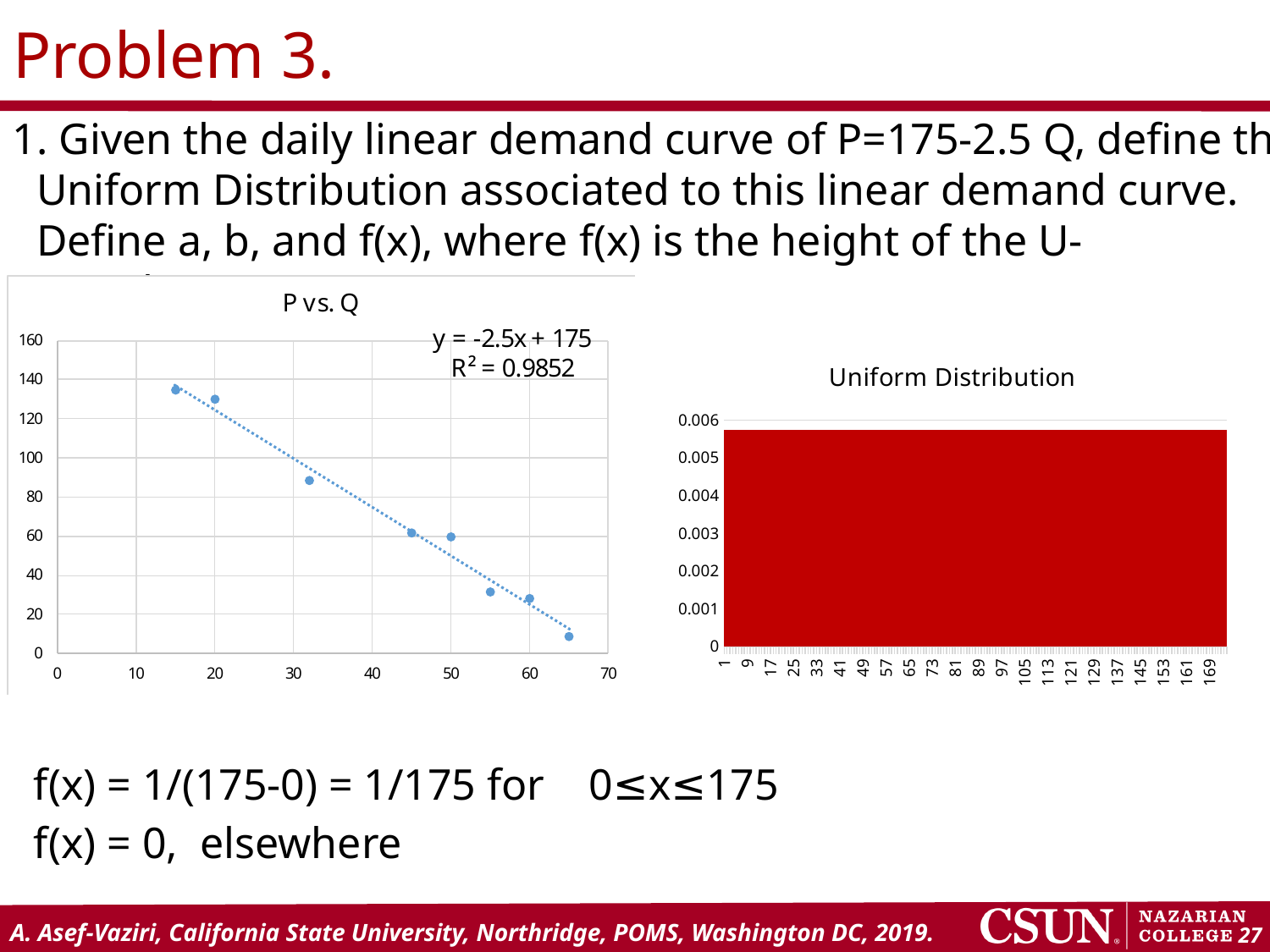
In the "P vs. Q" chart, is the value of the point at x = 15 greater or less than 120? greater What kind of chart is the "P vs. Q" chart on the left? scatter chart How many data points are plotted in the "P vs. Q" chart? 8 In the "P vs. Q" chart, is the value of the point at x = 65 greater or less than 20? less What R² value is shown on the "P vs. Q" chart? 0.9852 In the "P vs. Q" chart, is the point at x = 20 higher or lower than the point at x = 60? higher What is the trendline equation shown on the "P vs. Q" chart? y = -2.5x + 175 What kind of chart is the "Uniform Distribution" chart on the right? area chart In the "P vs. Q" chart, do the plotted values rise or fall as x increases? fall In the "Uniform Distribution" chart, do the bar heights rise, fall, or stay flat across the x axis? stay flat In the "Uniform Distribution" chart, are the bar heights greater or less than 0.005? greater